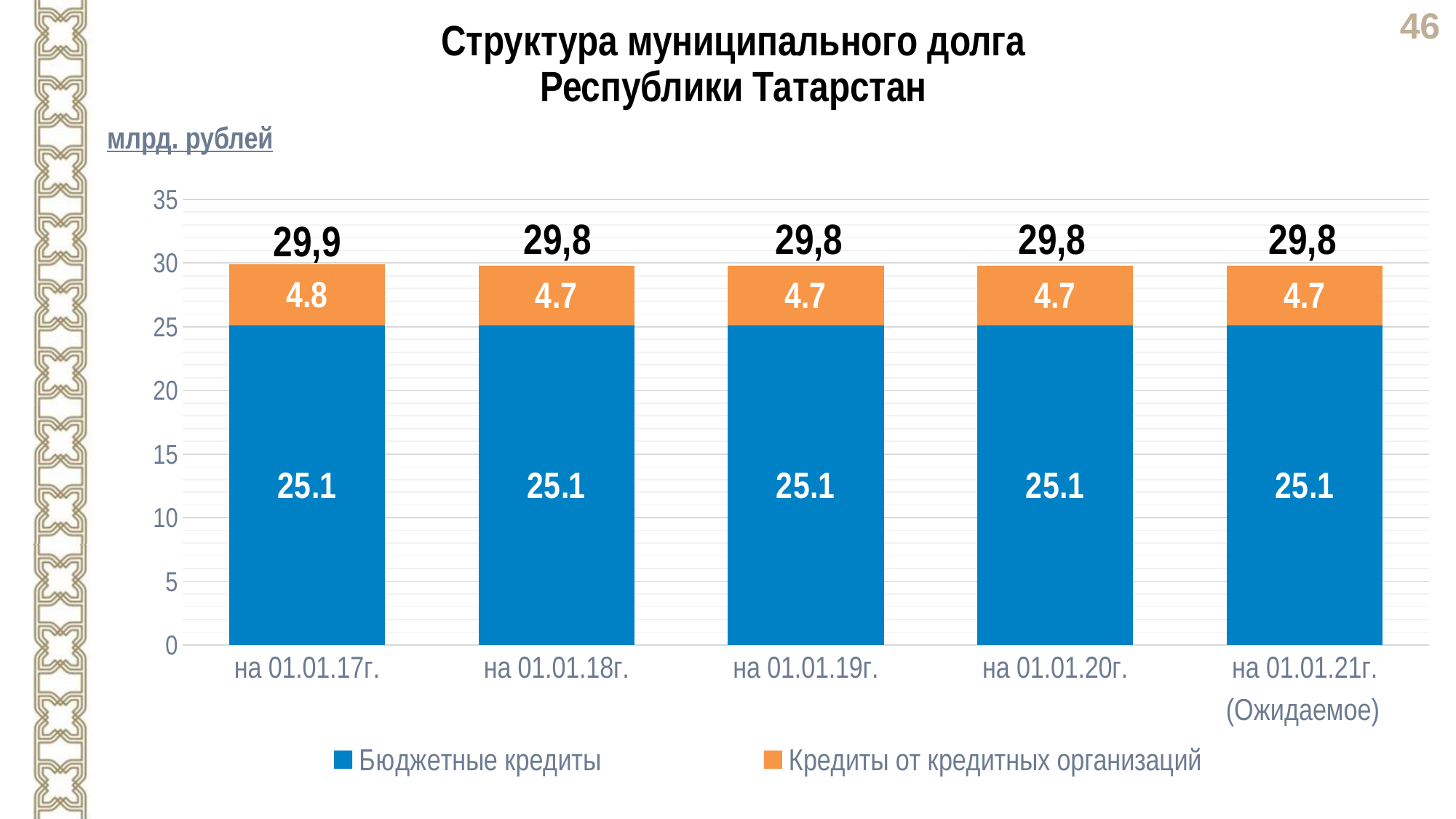
What is the value of Кредиты от кредитных организаций for на 01.01.20г.? 4.7 What is the value of Бюджетные кредиты for на 01.01.17г.? 25.1 What is the total of the stacked bar for на 01.01.17г.? 29,9 What kind of chart is shown on the slide? Stacked bar chart What is the total of the stacked bar for на 01.01.21г. (Ожидаемое)? 29,8 What is the value of Кредиты от кредитных организаций for на 01.01.17г.? 4.8 What unit is stated above the chart? млрд. рублей How many categories (dates) are shown on the x axis? 5 How many series does the legend list? 2 Which is larger for на 01.01.19г.: Бюджетные кредиты or Кредиты от кредитных организаций? Бюджетные кредиты What is the difference between the Кредиты от кредитных организаций value for на 01.01.17г. and for на 01.01.18г.? 0.1 Which date has the highest total municipal debt? на 01.01.17г.